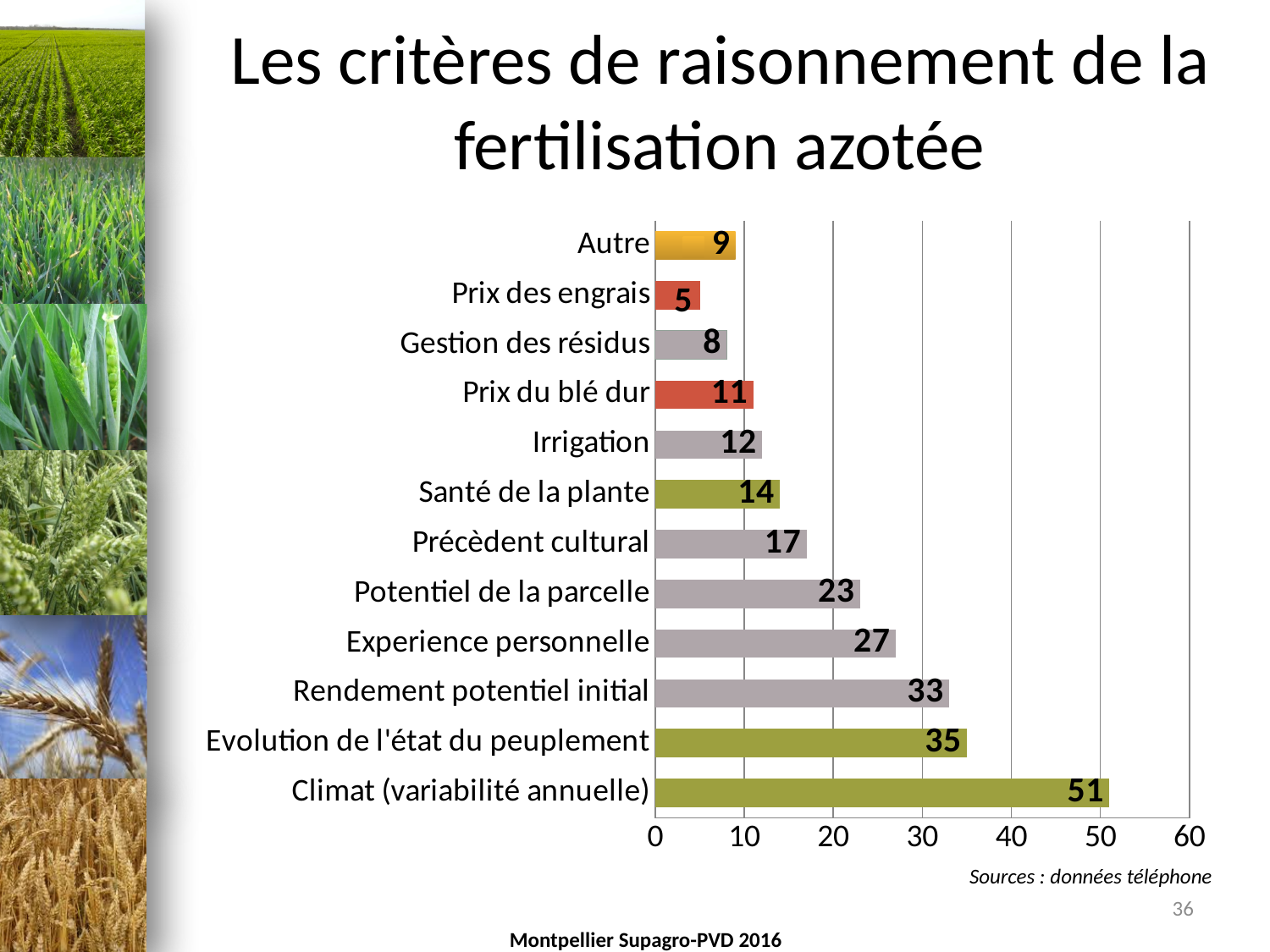
Which category has the highest value? Climat (variabilité annuelle) What is the maximum value shown on the horizontal axis? 60 What is the difference between the values for Climat (variabilité annuelle) and Evolution de l'état du peuplement? 16 What kind of chart is shown on the slide? bar chart What is the difference between the values for Irrigation and Gestion des résidus? 4 How many categories are shown in the chart? 12 What is the value for Climat (variabilité annuelle)? 51 What is the value for Experience personnelle? 27 Which is larger, the value for Rendement potentiel initial or the value for Potentiel de la parcelle? Rendement potentiel initial Which category has the lowest value? Prix des engrais What is the value for Prix du blé dur? 11 Is the value for Précèdent cultural greater or less than 20? less